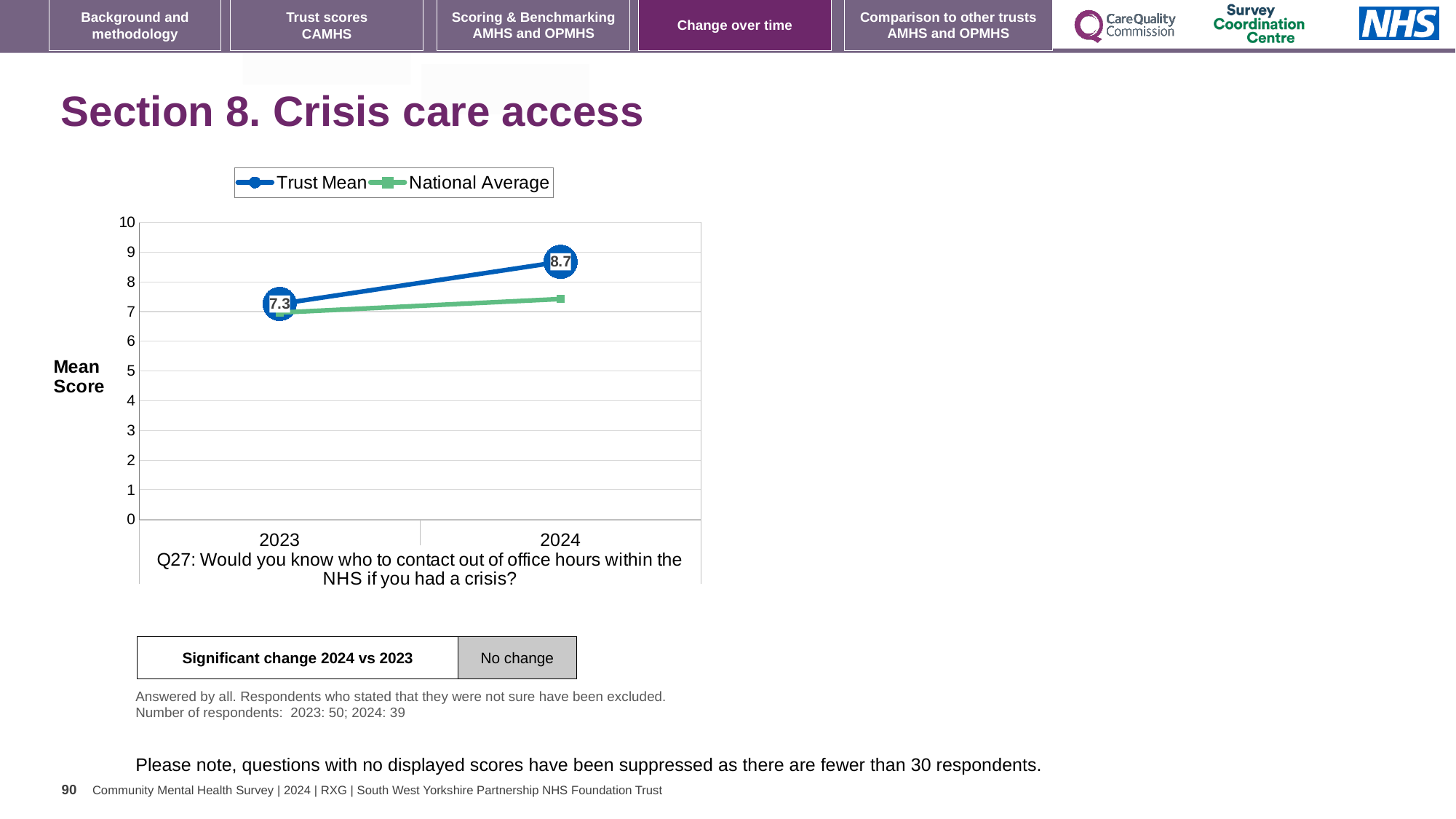
What kind of chart is shown on the slide? line chart In which year is the Trust Mean score higher? 2024 By how much did the Trust Mean score change from 2023 to 2024? 1.4 What is the Trust Mean score for 2024? 8.7 Does the Trust Mean score rise or fall from 2023 to 2024? rise In which year is the Trust Mean score lower? 2023 How many series does the legend list? 2 Is the National Average value for 2024 greater or less than 8? less Is the National Average value for 2023 greater or less than 6? greater How many years are plotted on the x axis? 2 What is the Trust Mean score for 2023? 7.3 In 2024, which is larger: the Trust Mean or the National Average? Trust Mean